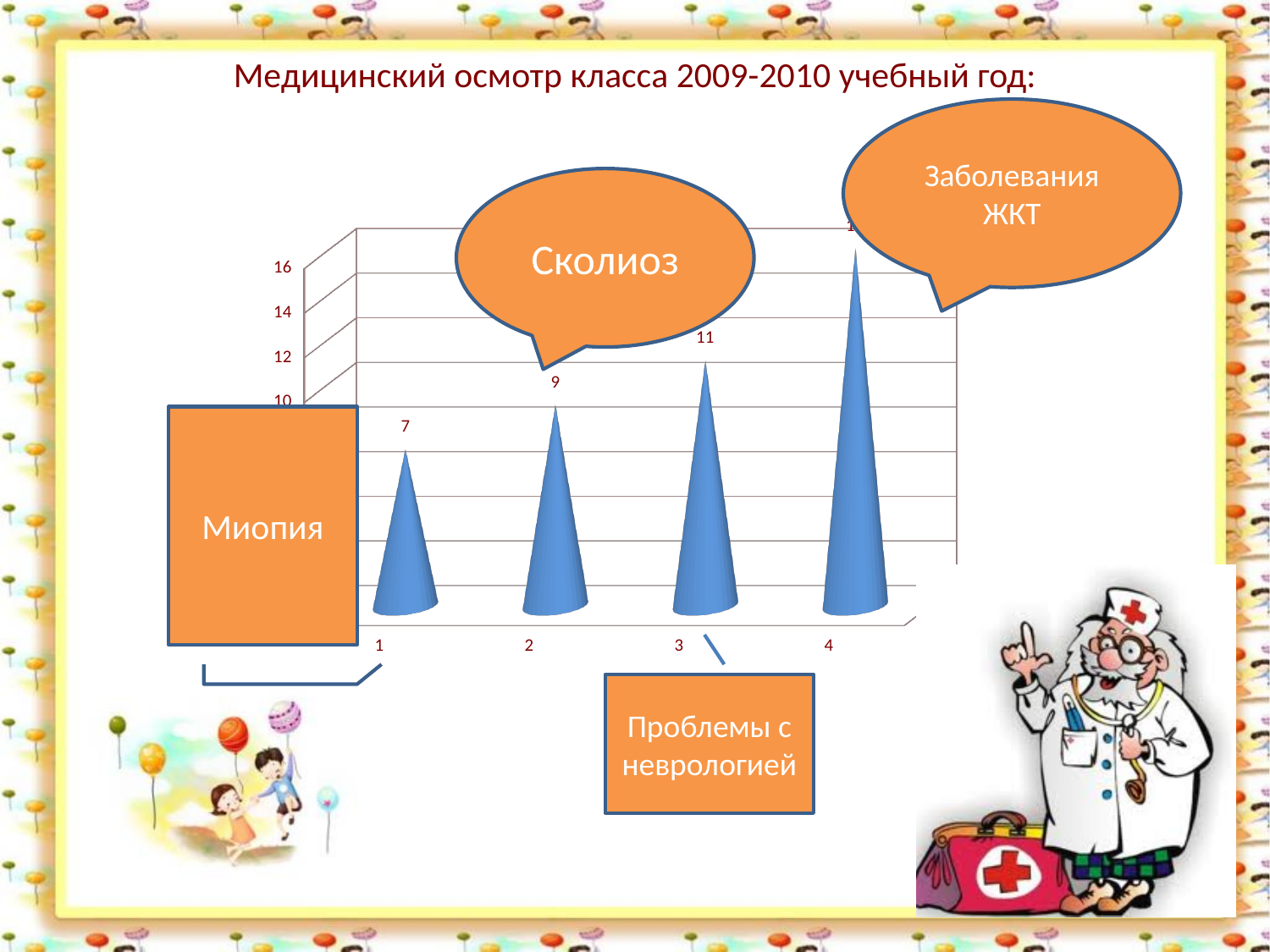
What is the value for category 2 in the chart? 9 Which category has the highest value in the chart? 4 How many categories are shown on the x axis of the chart? 4 Which is larger, the value for category 2 or the value for category 3? category 3 What is the difference between the values for category 3 and category 1? 4 Do the values rise or fall from category 1 to category 4? rise What is the title of the slide containing the chart? Медицинский осмотр класса 2009-2010 учебный год: What is the difference between the values for category 2 and category 1? 2 Is the value for category 4 greater or less than 12? greater What is the value for category 3 in the chart? 11 Which category has the lowest value in the chart? 1 What is the value for category 1 in the chart? 7